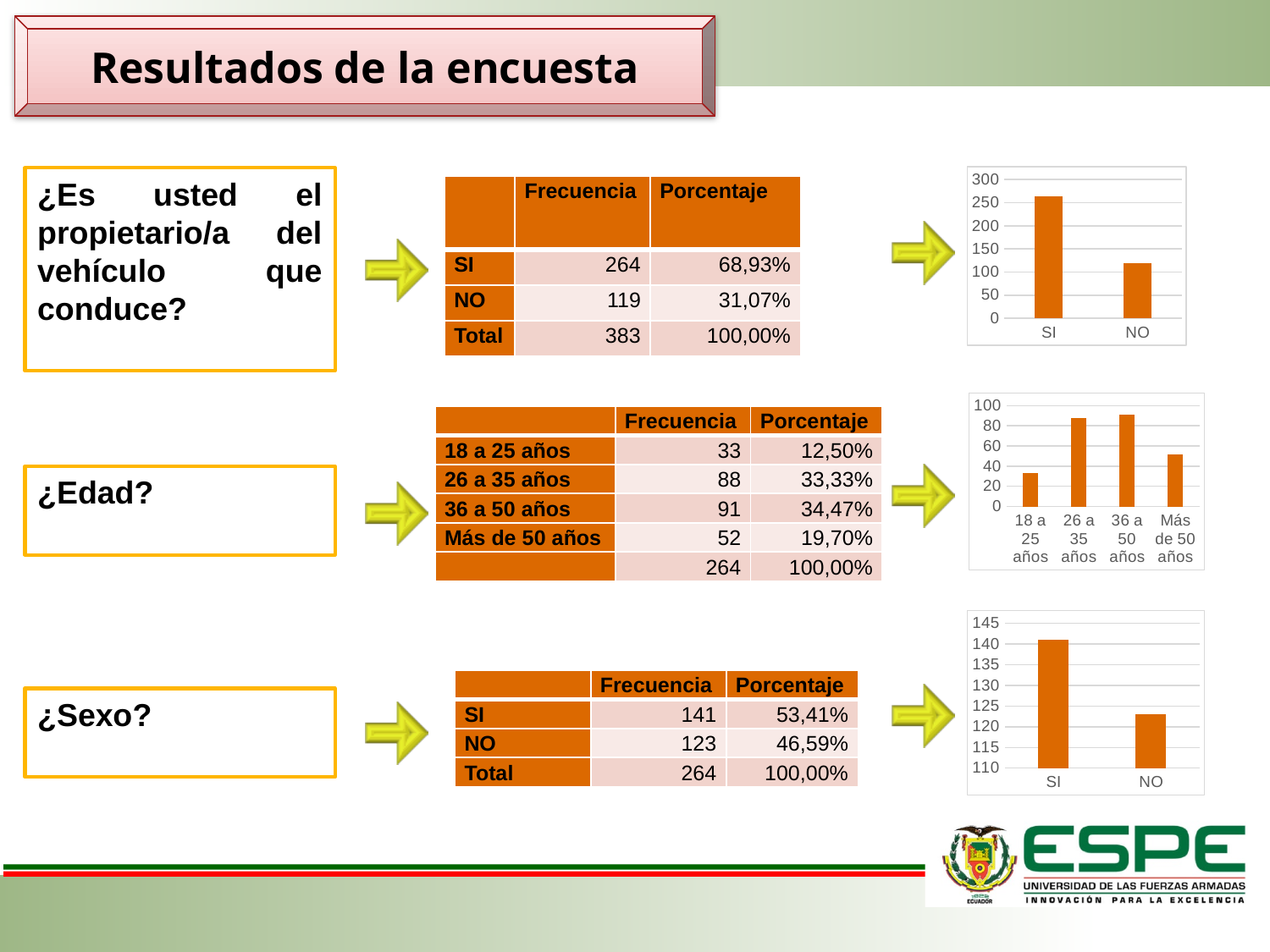
What kind of chart is the top-right chart next to the question about vehicle ownership? bar chart In the top-right chart (SI/NO for vehicle ownership), how many categories are shown on the x axis? 2 In the middle chart next to '¿Edad?', is the value for 'Más de 50 años' greater or less than 40? greater In the top-right chart (SI/NO for vehicle ownership), is the value for SI greater or less than 200? greater In the middle chart next to '¿Edad?', is the value for '18 a 25 años' greater or less than 40? less In the middle chart next to '¿Edad?', which age category has the lowest bar? 18 a 25 años In the bottom chart next to '¿Sexo?', which category has the highest bar? SI In the middle chart next to '¿Edad?', which is larger: the bar for 'Más de 50 años' or the bar for '18 a 25 años'? Más de 50 años In the top-right chart (SI/NO for vehicle ownership), which category has the highest bar? SI In the middle chart next to '¿Edad?', how many age categories are plotted? 4